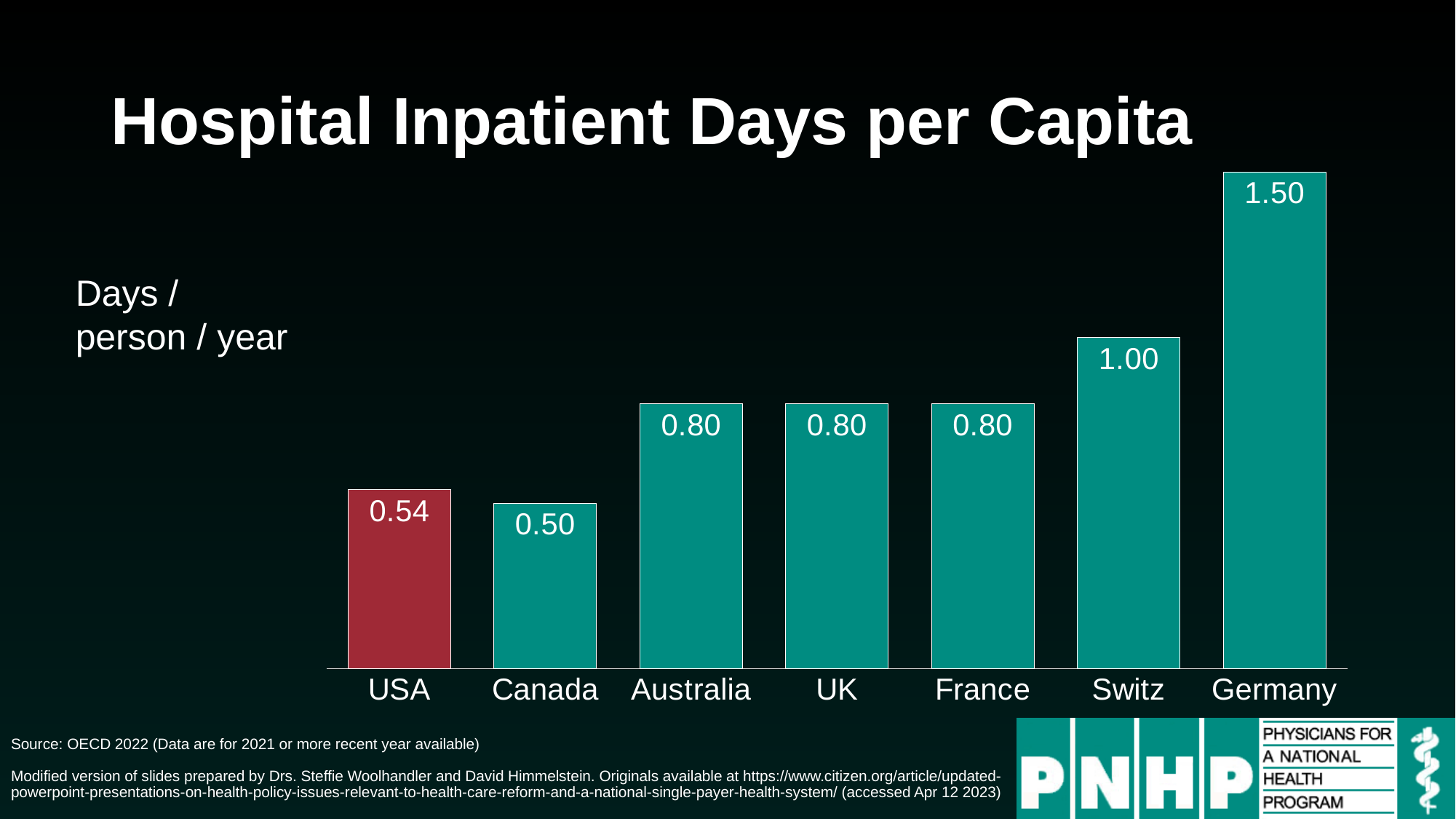
What kind of chart is shown on the slide? Bar chart What is the value for the USA? 0.54 Which is larger, the value for the USA or the value for France? France What is the difference between Germany's value and the USA's value? 0.96 Which country has the highest hospital inpatient days per capita? Germany Which bar is shown in a different colour (red) from the others? USA What is the value for Canada? 0.50 What is the value for Switz? 1.00 What is the value for Germany? 1.50 What is the difference between Switz and Canada? 0.50 How many countries are shown in the chart? 7 Which country has the lowest hospital inpatient days per capita? Canada